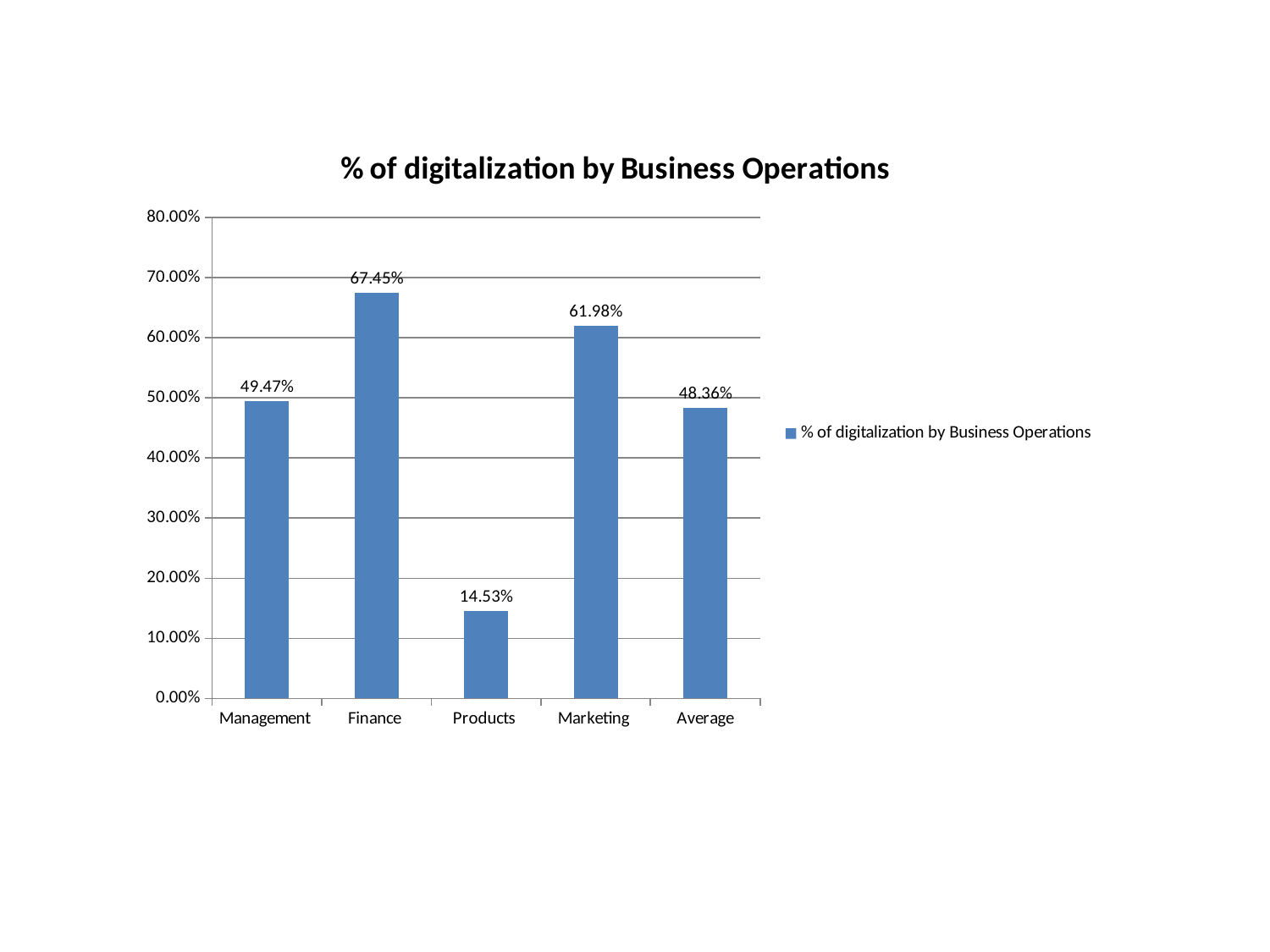
Is the value for Management greater or less than 40.00%? greater Which is larger, the value for Management or the value for Marketing? Marketing How many series does the legend list? 1 Which category has the highest value? Finance What kind of chart is shown? bar chart What is the title of the chart? % of digitalization by Business Operations What is the value for Products? 14.53% What is the value for Finance? 67.45% What is the difference between the values for Finance and Marketing? 5.47% How many categories are shown on the x axis? 5 What is the value for Average? 48.36% Which category has the lowest value? Products